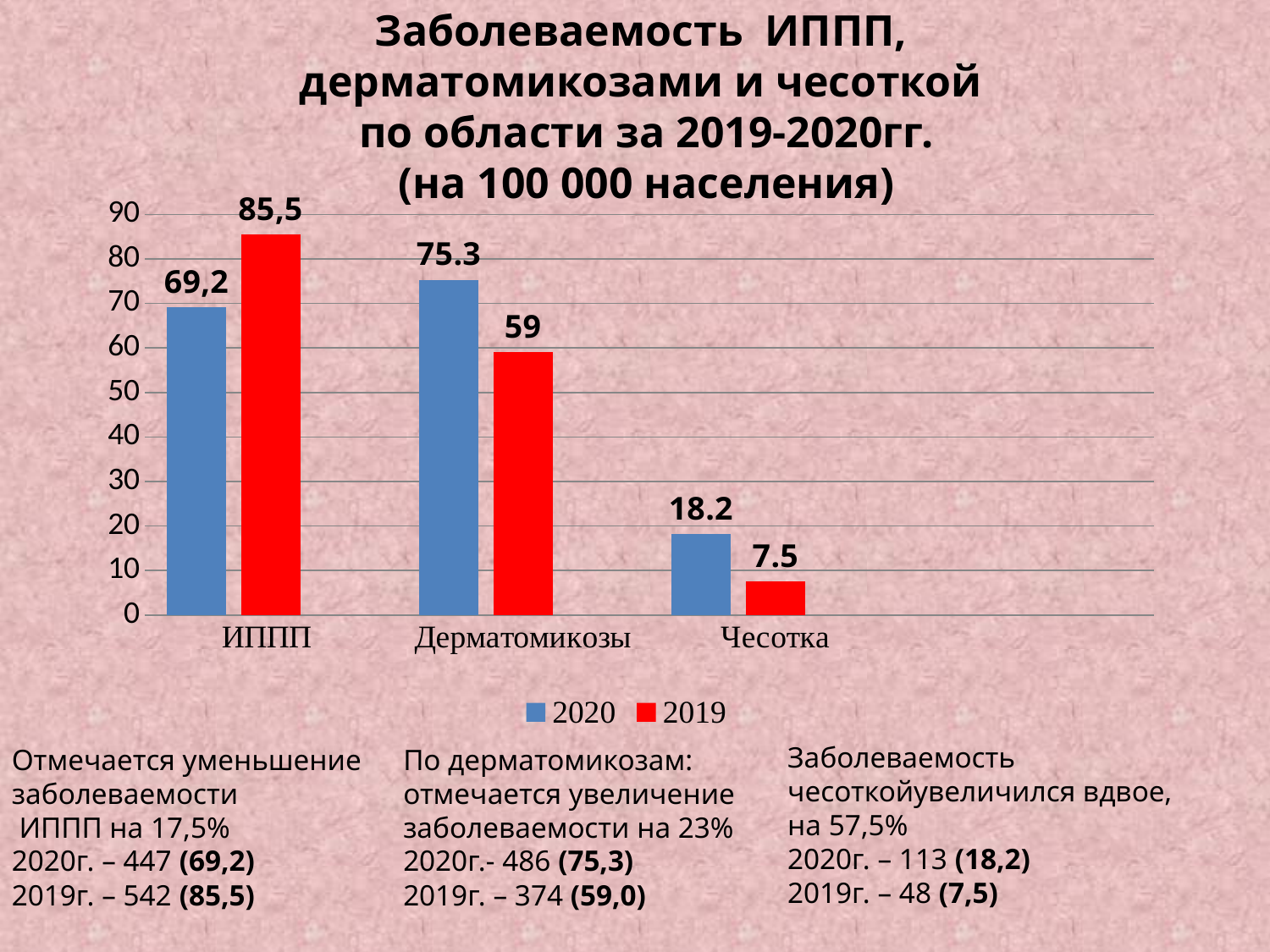
What kind of chart is shown on the slide? Bar chart What is the value for Дерматомикозы in the 2020 series? 75.3 What is the value for Чесотка in the 2019 series? 7.5 What is the value for ИППП in the 2020 series? 69,2 What is the difference between the 2020 and 2019 values for Чесотка? 10.7 Which category has the lowest value in the 2020 series? Чесотка How many categories are shown on the x axis? 3 What is the value for ИППП in the 2019 series? 85,5 Which category has the highest value in the 2019 series? ИППП How many series does the legend list? 2 For Дерматомикозы, which series has the larger value, 2020 or 2019? 2020 What is the difference between the 2019 and 2020 values for ИППП? 16,3